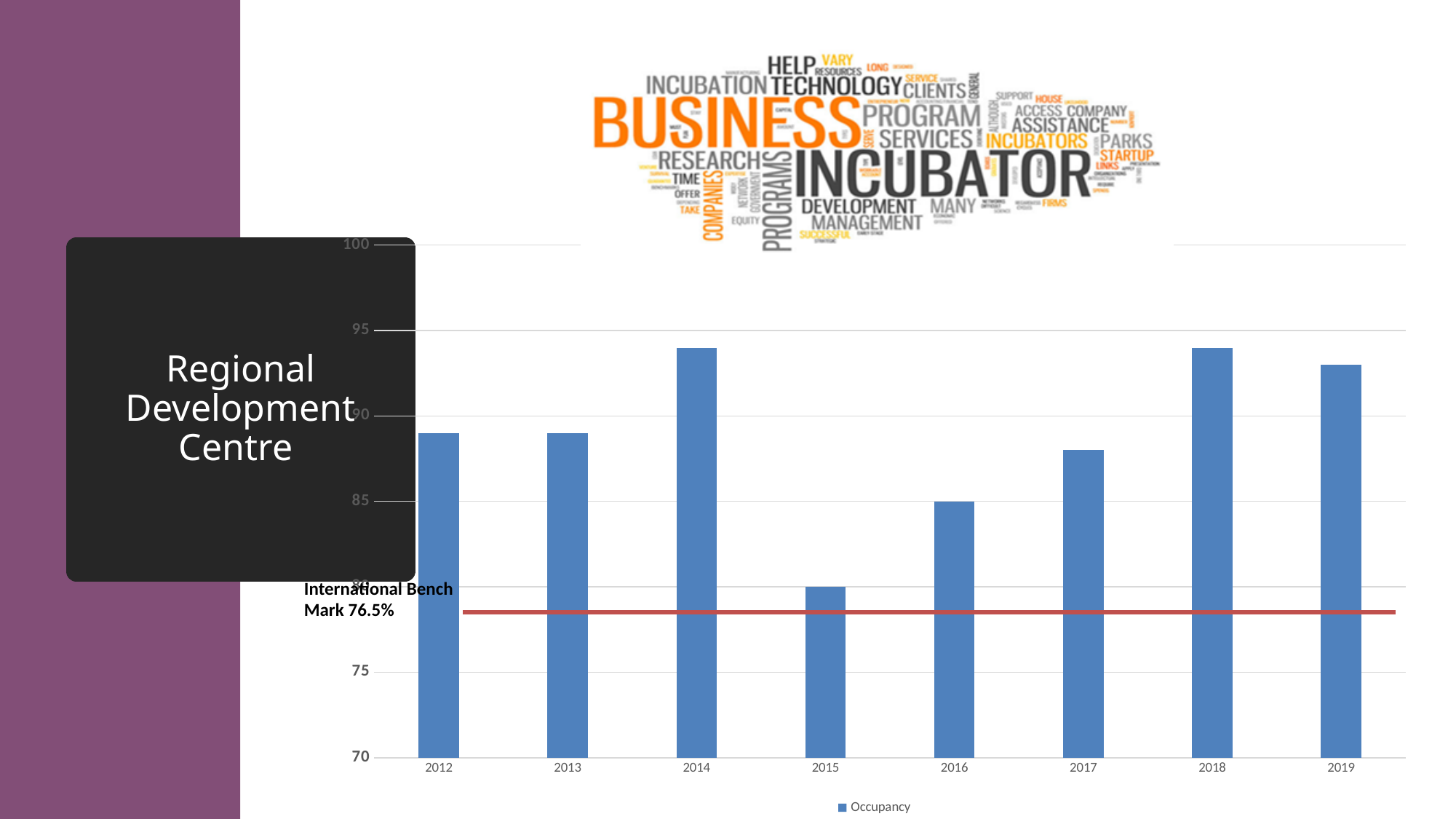
Is the Occupancy value for 2016 greater or less than 90? less Is the Occupancy value for 2014 greater or less than 90? greater How many years are shown on the x axis of the chart? 8 What is the name of the series shown in the chart legend? Occupancy What kind of chart is shown on the slide? bar chart Which year has the lowest Occupancy value? 2015 How many series does the chart legend list? 1 Is the Occupancy value for 2015 greater or less than 85? less Do the Occupancy values rise or fall from 2015 to 2018? rise Which year has the larger Occupancy value, 2014 or 2015? 2014 What value is given for the International Bench Mark line on the chart? 76.5%